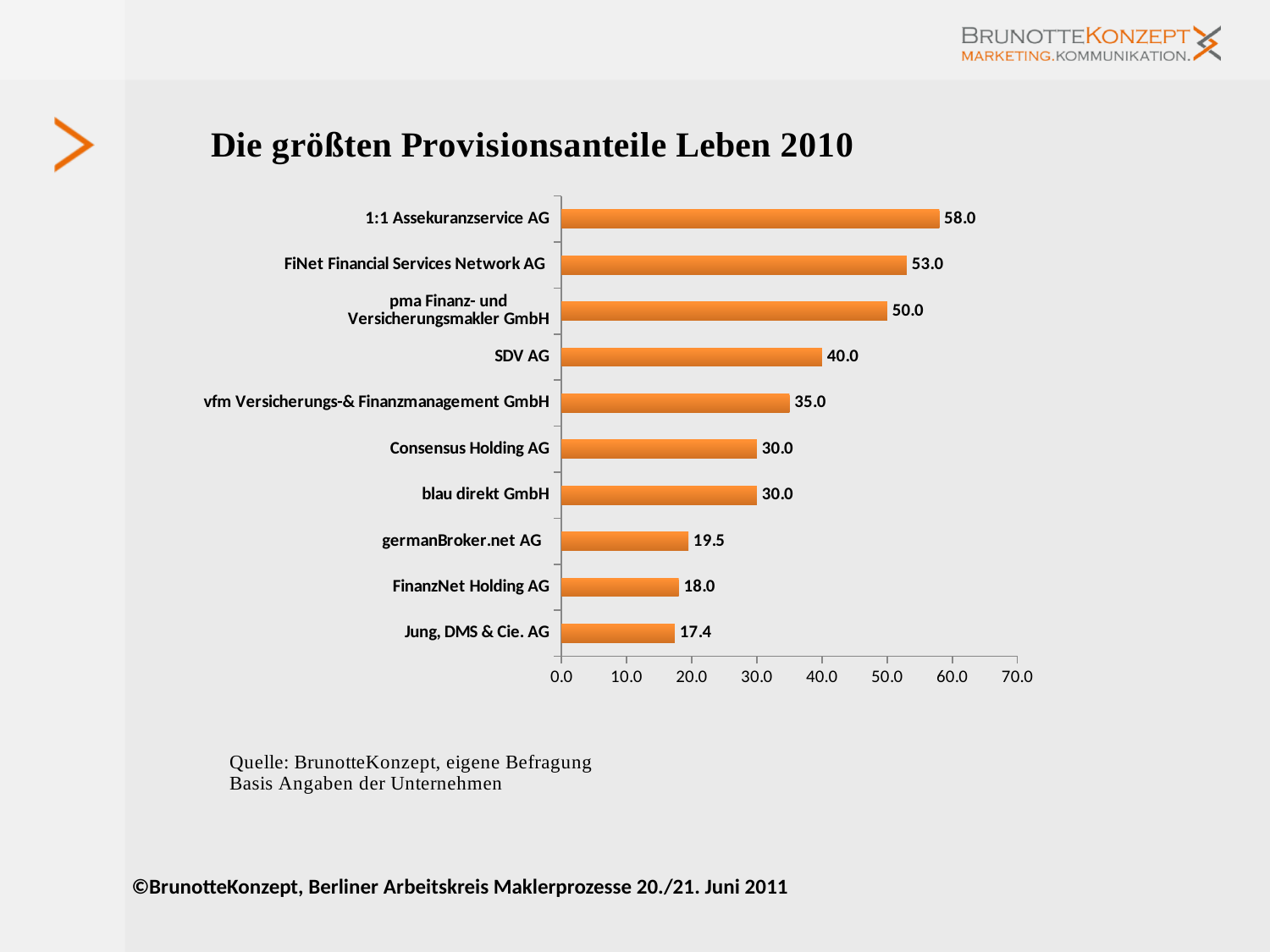
How many companies are shown in the chart? 10 Is the value for FinanzNet Holding AG greater or less than 20.0? less Which company has the lowest value? Jung, DMS & Cie. AG What is the difference between the values for FiNet Financial Services Network AG and pma Finanz- und Versicherungsmakler GmbH? 3.0 What is the value for germanBroker.net AG? 19.5 What is the value for Jung, DMS & Cie. AG? 17.4 What is the title of the chart? Die größten Provisionsanteile Leben 2010 What kind of chart is shown on the slide? bar chart What is the value for 1:1 Assekuranzservice AG? 58.0 What is the value for SDV AG? 40.0 Which is larger, the value for vfm Versicherungs-& Finanzmanagement GmbH or the value for Consensus Holding AG? vfm Versicherungs-& Finanzmanagement GmbH Which company has the highest value? 1:1 Assekuranzservice AG